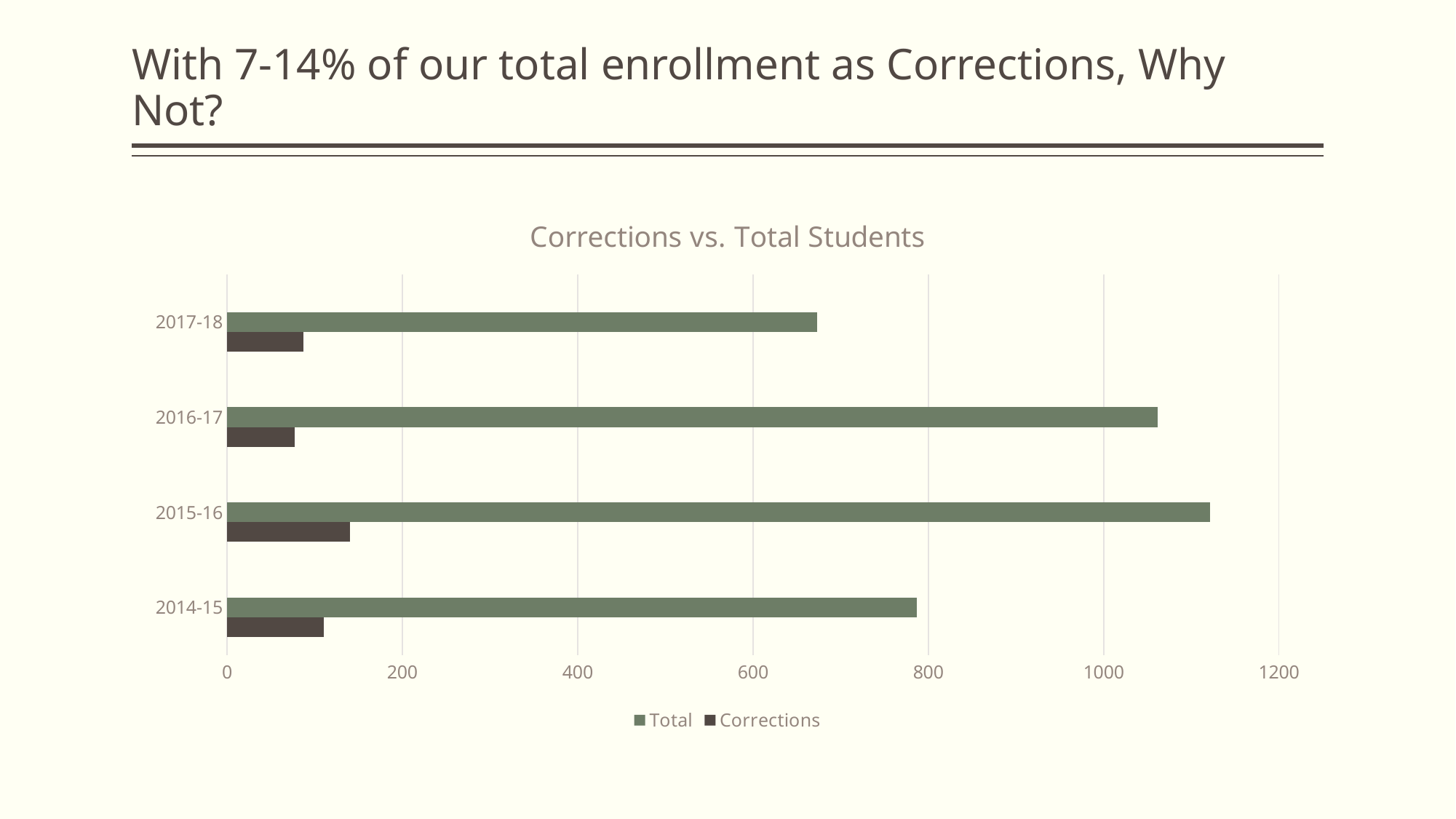
How many school years are shown on the chart? 4 Which is larger, the Total value for 2015-16 or the Total value for 2016-17? 2015-16 Which school year has the lowest Total value? 2017-18 What kind of chart is shown on the slide? bar chart Is the Total value for 2015-16 greater or less than 1000? greater How many series does the legend list? 2 Is the Total value for 2017-18 greater or less than 800? less Which series is shown in the darker brown colour? Corrections Is the Corrections value for 2015-16 greater or less than 200? less Which school year has the highest Corrections value? 2015-16 Which school year has the highest Total value? 2015-16 What is the title of the chart? Corrections vs. Total Students